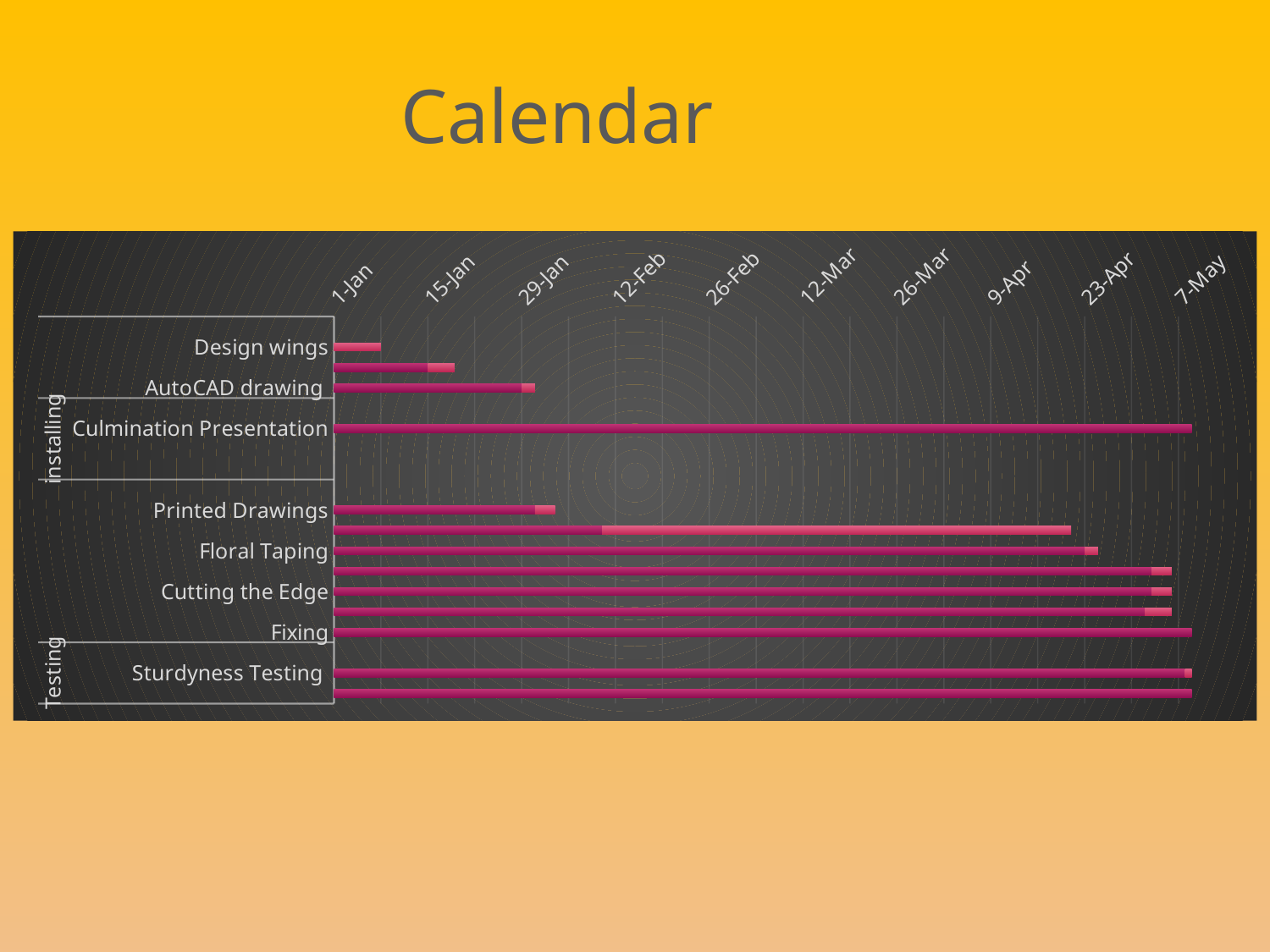
Does the bar for Design wings end before or after 15-Jan? before What is the first date tick shown on the x axis of the chart? 1-Jan Does the bar for Design wings extend past 12-Feb? no How many task labels are readable on the y axis of the chart? 8 Which bar is longer, Floral Taping or Design wings? Floral Taping How many date ticks are shown along the x axis of the chart? 10 Does the bar for Cutting the Edge extend past 23-Apr? yes Which labeled task has the shortest bar in the chart? Design wings Which bar is longer, Design wings or Culmination Presentation? Culmination Presentation What kind of chart is shown on the slide? bar chart What is the title of the slide containing the chart? Calendar Which task label appears at the bottom of the y axis? Sturdyness Testing